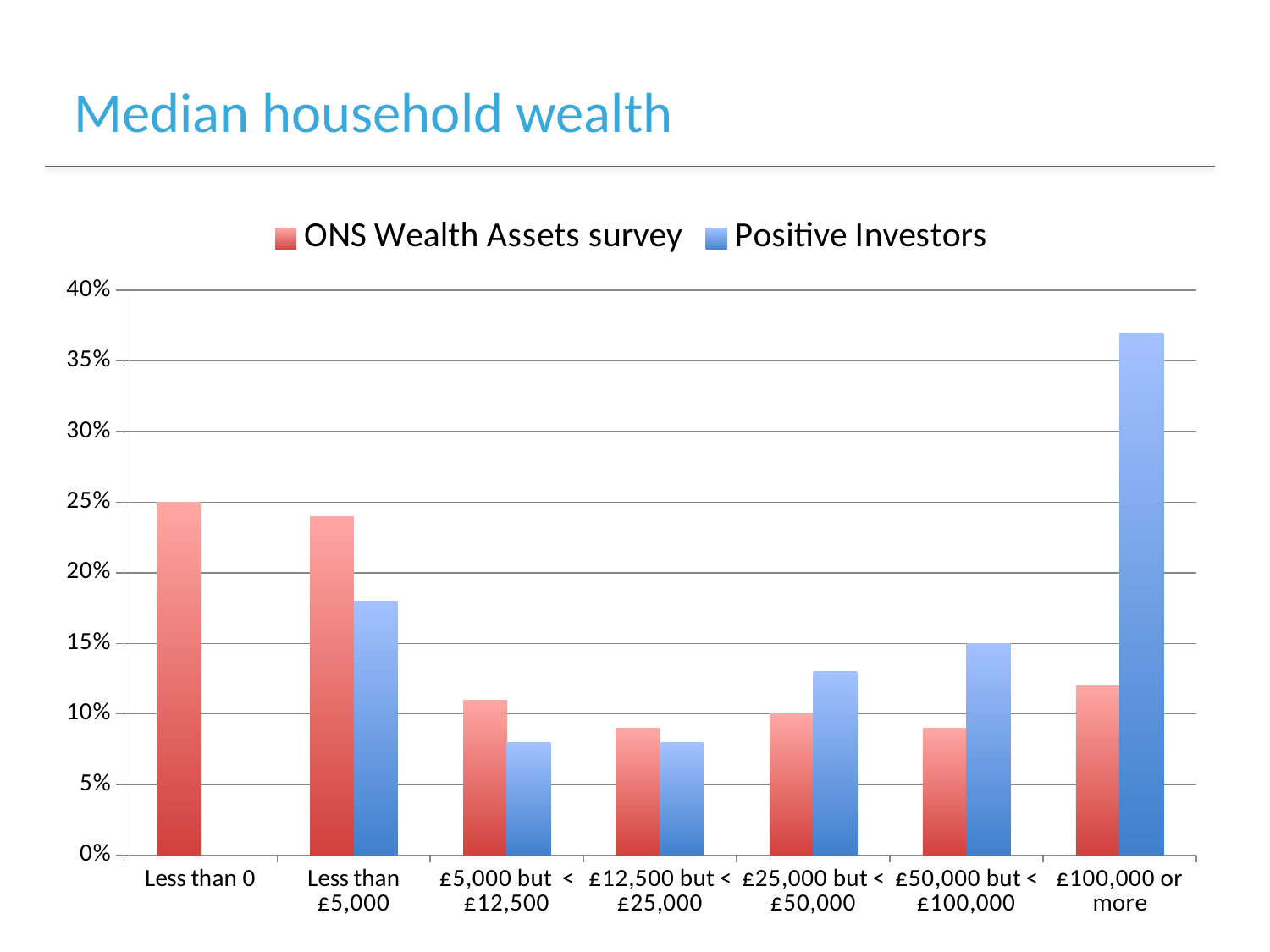
What is the title of the chart? Median household wealth Which category has the highest value for Positive Investors? £100,000 or more Is the ONS Wealth Assets survey value for Less than £5,000 greater or less than 20%? greater How many wealth categories are shown on the x axis? 7 Is the Positive Investors value for £5,000 but < £12,500 greater or less than 10%? less Which category has the highest value for the ONS Wealth Assets survey? Less than 0 For the Less than £5,000 category, which series has the larger value? ONS Wealth Assets survey Is the Positive Investors value for £100,000 or more greater or less than 35%? greater For the £100,000 or more category, which series has the larger value? Positive Investors What kind of chart is shown on the slide? bar chart How many series does the legend list? 2